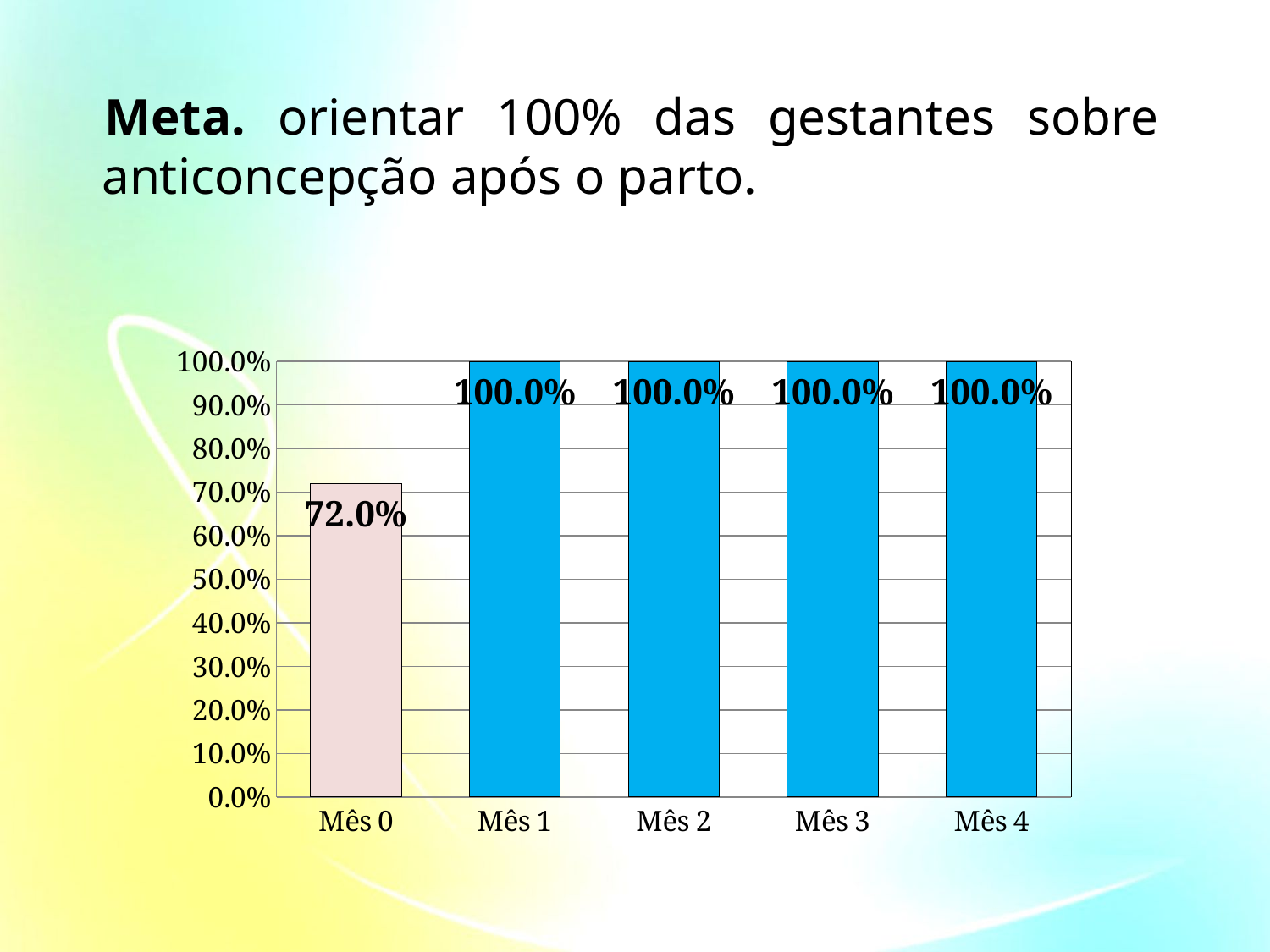
What kind of chart is shown on the slide? bar chart What is the difference between the value for Mês 1 and the value for Mês 0? 28.0% Which is larger, the value for Mês 0 or the value for Mês 3? Mês 3 What is the value for Mês 0? 72.0% What is the value for Mês 4? 100.0% Which category has the lowest value? Mês 0 How many bars reach 100.0%? 4 What is the value for Mês 2? 100.0% Which bar has a different colour from the others? Mês 0 Do the values rise or fall from Mês 0 to Mês 1? rise Is the value for Mês 0 greater or less than 80.0%? less How many categories are shown on the x axis? 5